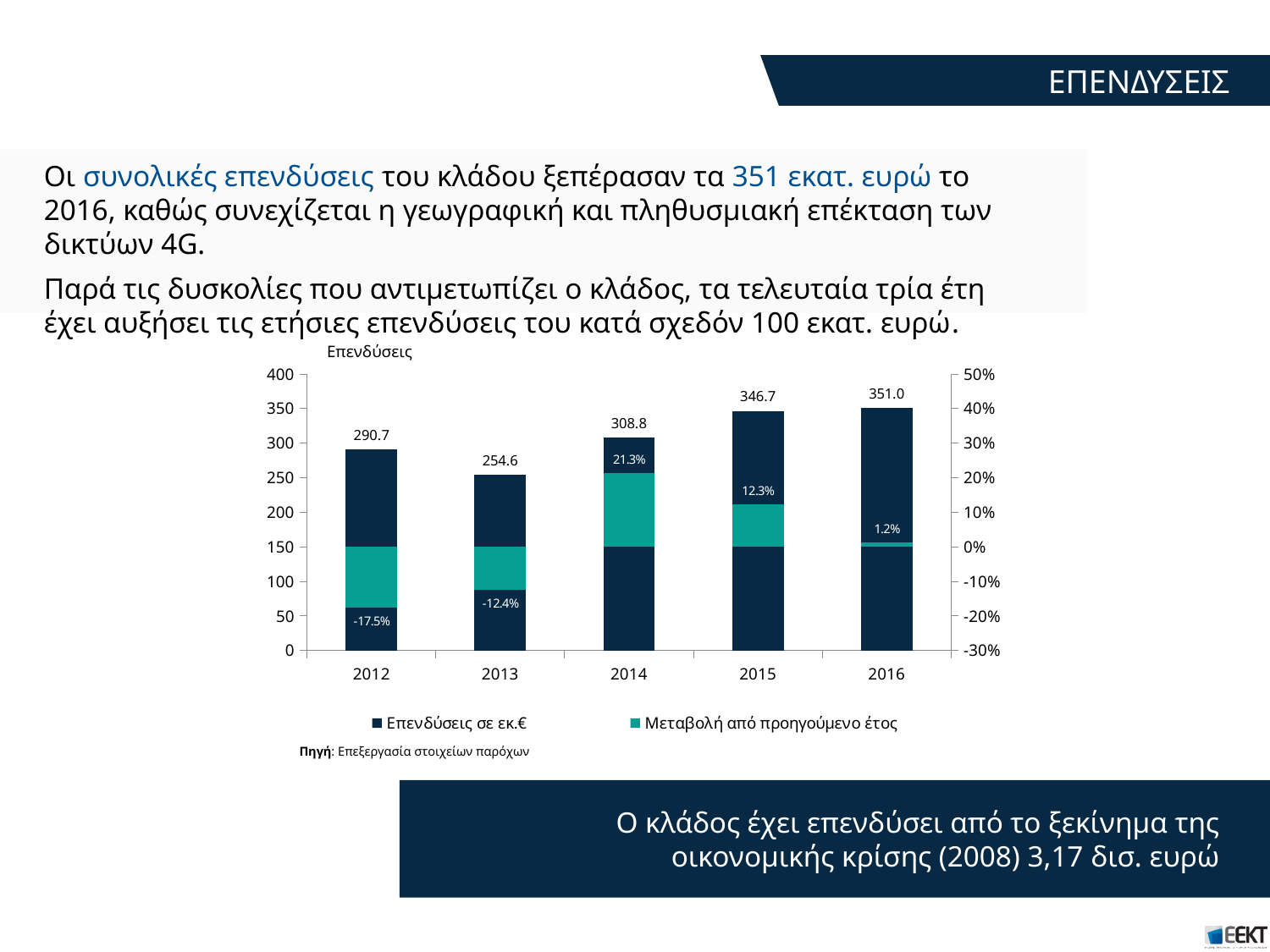
Which year has the lowest value of Επενδύσεις σε εκ.€? 2013 What is the Μεταβολή από προηγούμενο έτος for 2014? 21.3% How many series does the chart legend list? 2 Which is larger, Επενδύσεις σε εκ.€ in 2014 or in 2013? 2014 Which year has the highest Μεταβολή από προηγούμενο έτος? 2014 Do the values of Επενδύσεις σε εκ.€ rise or fall from 2013 to 2016? rise Which year has the highest value of Επενδύσεις σε εκ.€? 2016 What is the difference between Επενδύσεις σε εκ.€ in 2016 and in 2012? 60.3 What is the Μεταβολή από προηγούμενο έτος for 2012? -17.5% How many years are shown on the x axis of the chart? 5 What is the value of Επενδύσεις σε εκ.€ for 2016? 351.0 What is the value of Επενδύσεις σε εκ.€ for 2013? 254.6